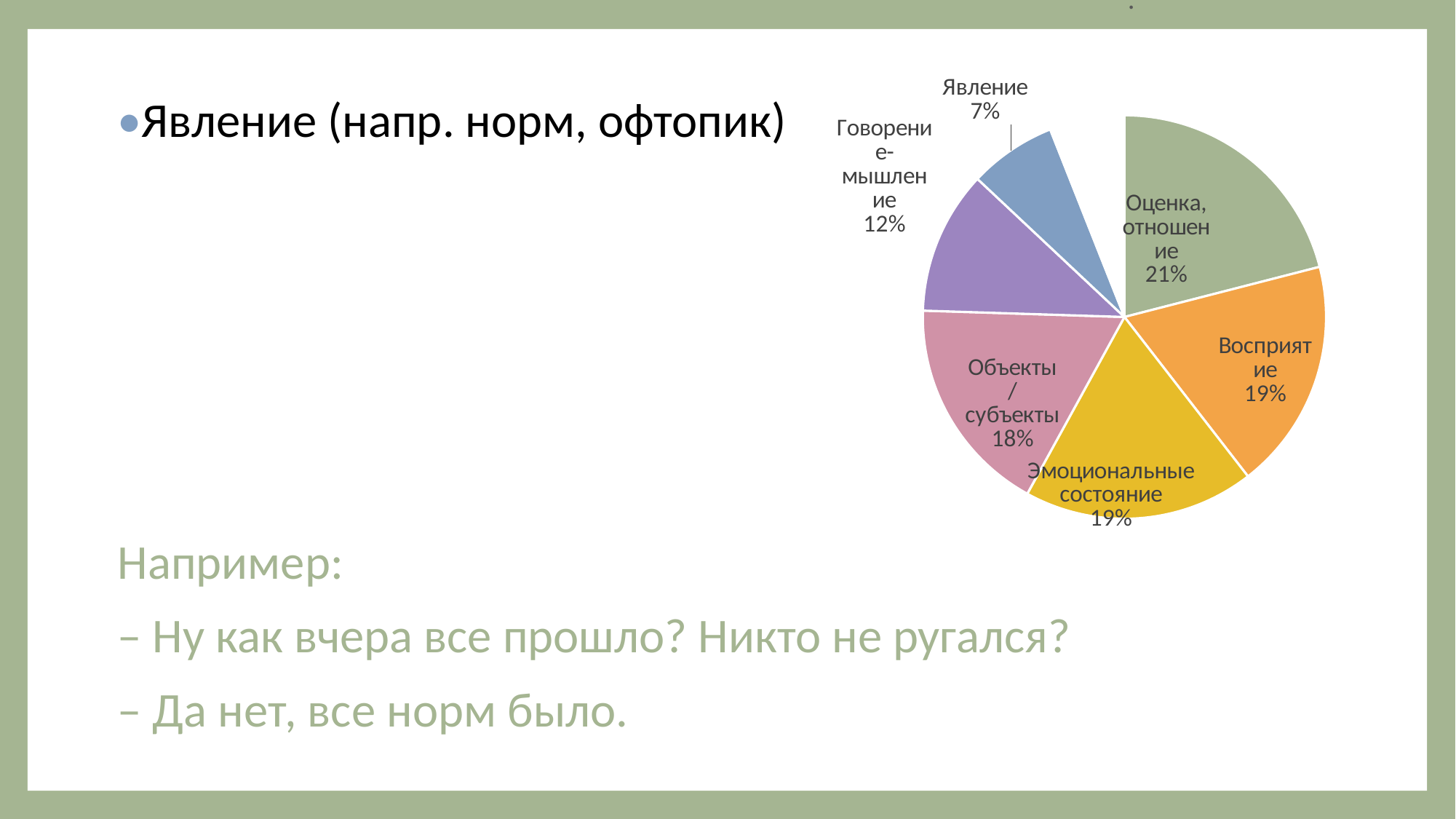
Which is larger: the share for "Восприятие" or the share for "Говорение-мышление"? Восприятие What colour is the "Явление" slice? blue What is the difference in percentage points between "Оценка, отношение" and "Явление"? 14 What percentage is shown for "Говорение-мышление"? 12% What percentage is shown for "Оценка, отношение"? 21% What type of chart is shown on the slide? pie chart Which category has the largest slice of the pie? Оценка, отношение What percentage is shown for "Восприятие"? 19% What percentage is shown for "Объекты / субъекты"? 18% What share of the pie does the "Явление" slice represent? 7%